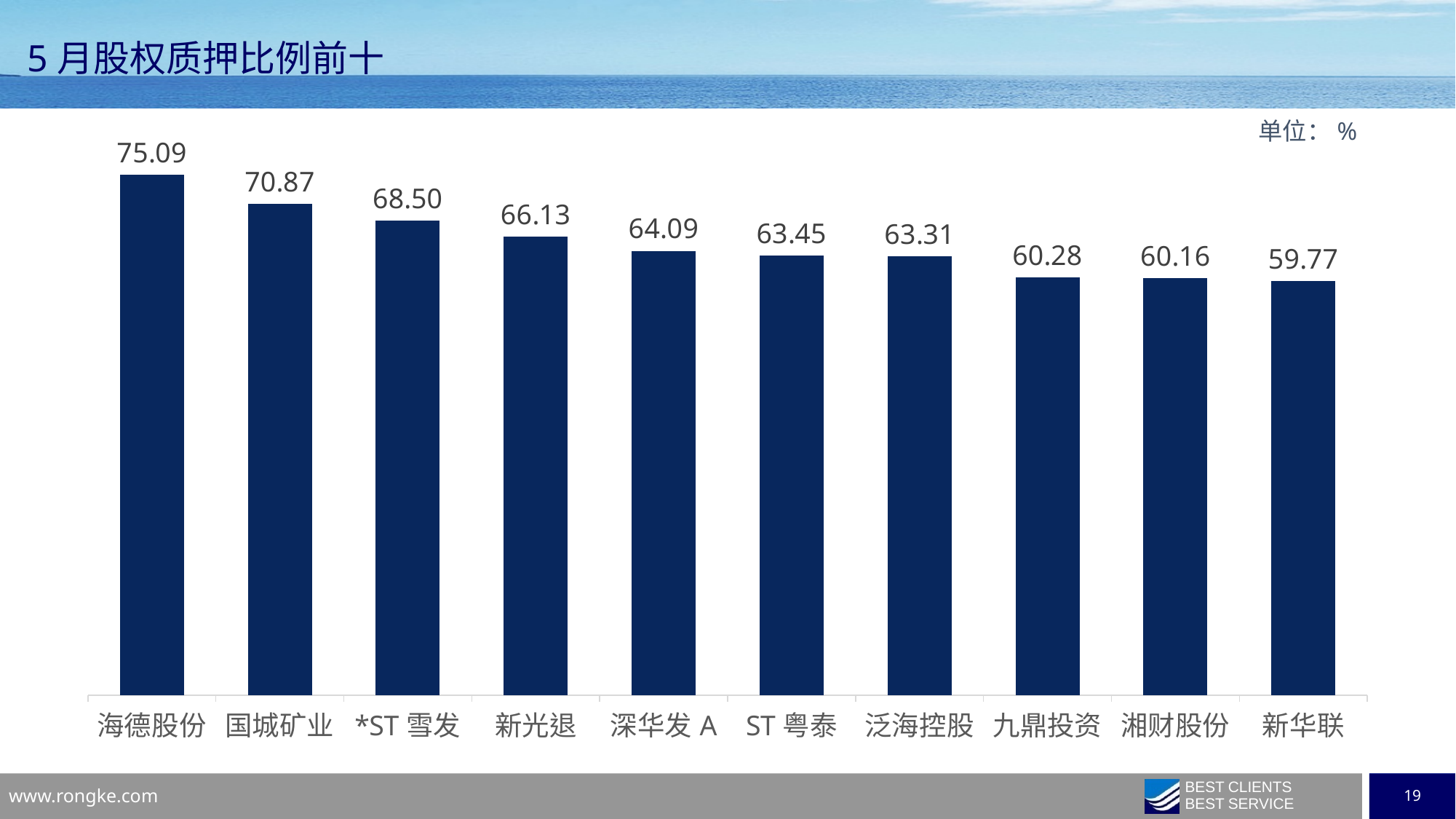
Which is larger, the value for 国城矿业 or the value for 泛海控股? 国城矿业 Do the values rise or fall from left to right along the x axis? fall What is the value for 海德股份? 75.09 Which category has the lowest value? 新华联 What unit is indicated for the values in the chart? % What is the difference between the values for 海德股份 and 国城矿业? 4.22 How many categories are shown in the chart? 10 What kind of chart is shown on the slide? bar chart What is the value for 新华联? 59.77 What is the difference between the values for *ST 雪发 and 新光退? 2.37 What is the value for 深华发 A? 64.09 Which category has the highest value? 海德股份